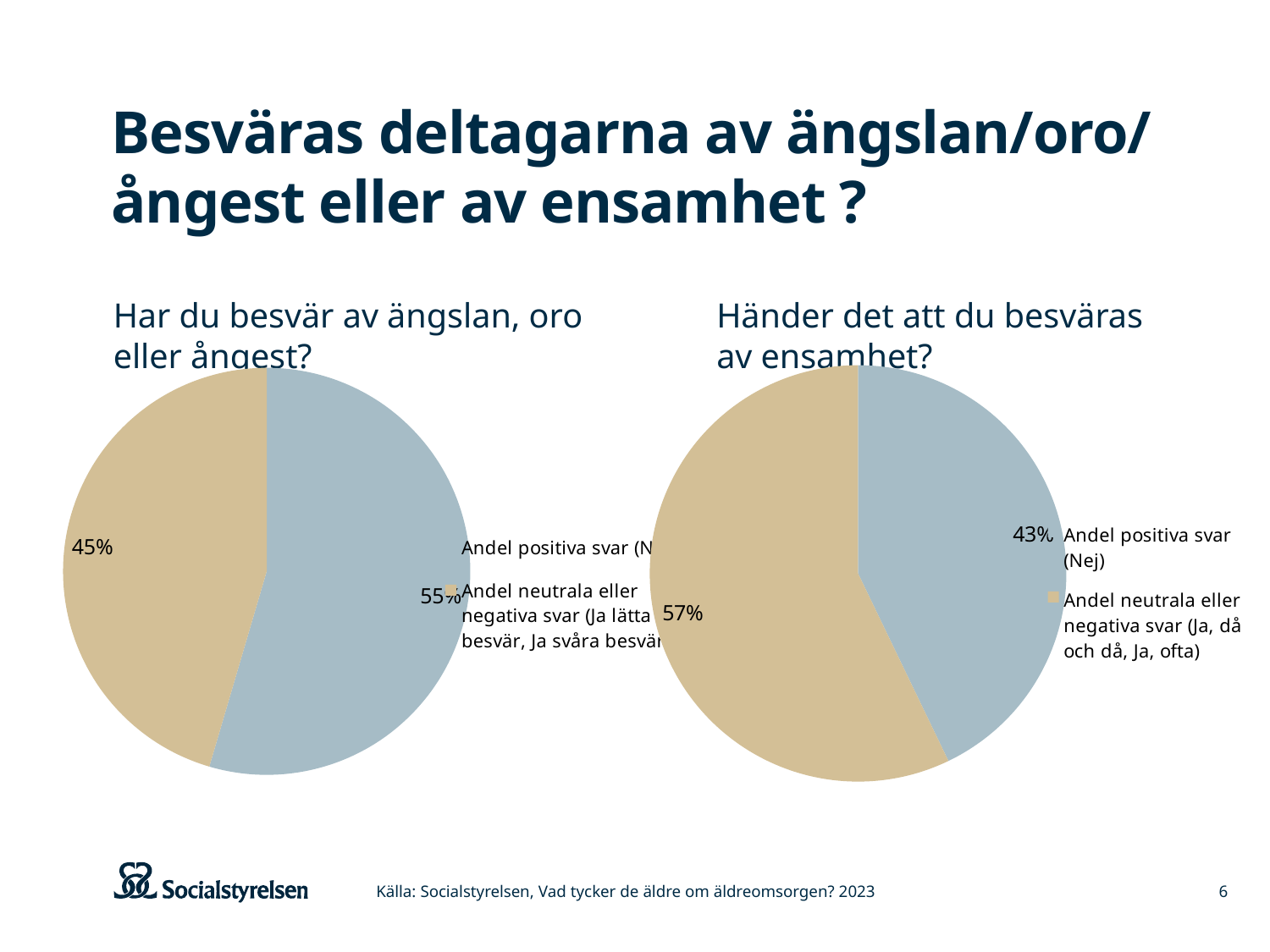
In the right chart 'Händer det att du besväras av ensamhet?', what share is labelled for the tan slice (Andel neutrala eller negativa svar)? 57% In the left chart 'Har du besvär av ängslan, oro eller ångest?', what share is labelled for the tan slice (Andel neutrala eller negativa svar)? 45% In the right chart 'Händer det att du besväras av ensamhet?', which slice is the largest? Andel neutrala eller negativa svar (57%) How many slices does the left chart 'Har du besvär av ängslan, oro eller ångest?' have? 2 In the right chart 'Händer det att du besväras av ensamhet?', what is the difference in percentage points between the two slices? 14 percentage points In the left chart 'Har du besvär av ängslan, oro eller ångest?', what share is labelled for the blue slice (Andel positiva svar)? 55% How many entries does the legend of the right chart 'Händer det att du besväras av ensamhet?' list? 2 In the right chart 'Händer det att du besväras av ensamhet?', what share is labelled for the blue slice (Andel positiva svar (Nej))? 43% Which share is larger: the positive answers (Nej) in the left chart or the positive answers (Nej) in the right chart? the left chart (55%) In the left chart 'Har du besvär av ängslan, oro eller ångest?', which slice is larger, the blue one or the tan one? the blue one (55%) What type of chart is used for 'Händer det att du besväras av ensamhet?' pie chart In the left chart 'Har du besvär av ängslan, oro eller ångest?', what is the difference in percentage points between the two slices? 10 percentage points